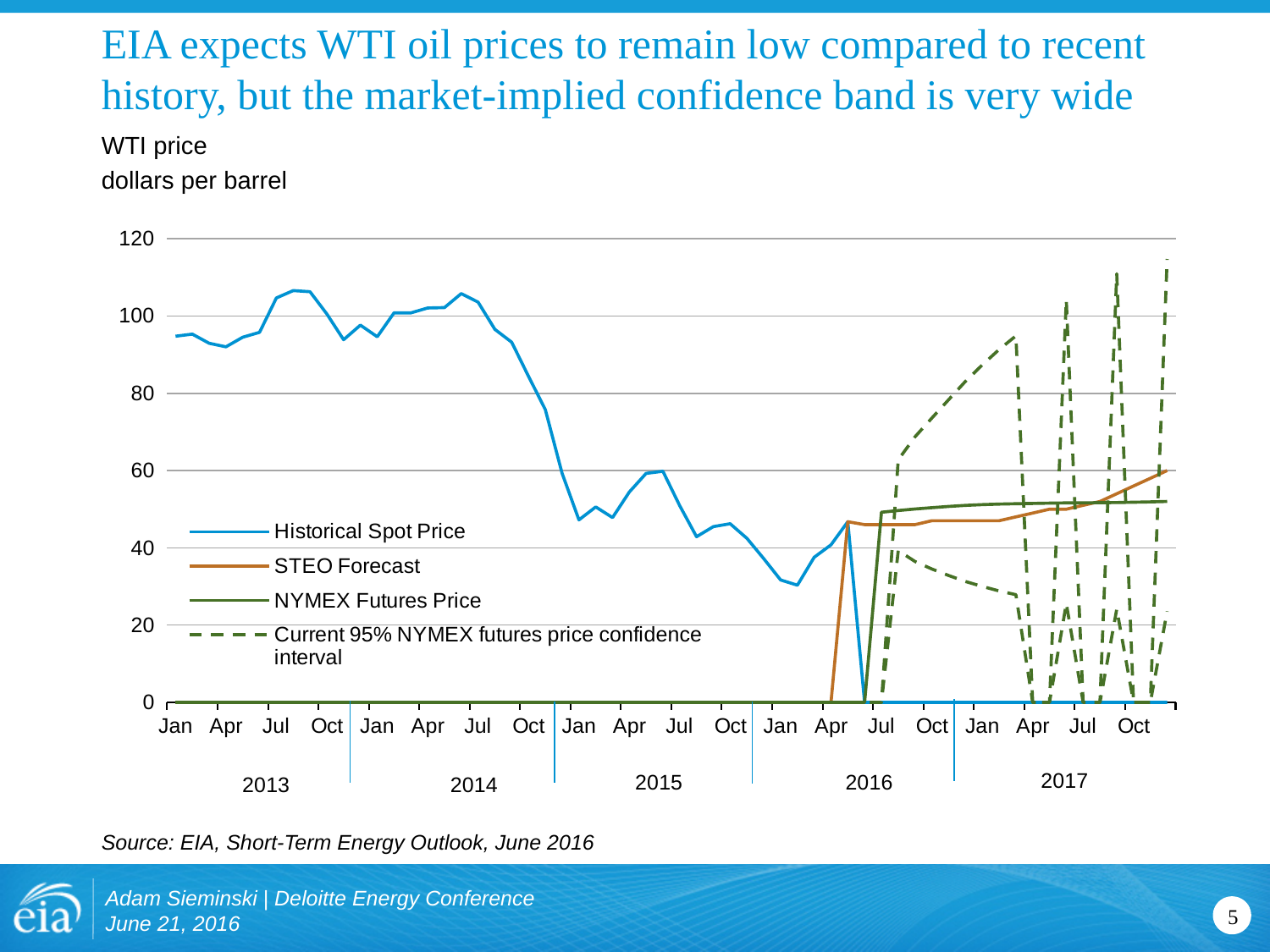
How many series does the chart legend list? 4 Is the STEO Forecast at the end of 2017 greater or less than 40 dollars per barrel? greater Does the Historical Spot Price rise or fall between mid-2014 and early 2016? fall What unit is the WTI price plotted in, according to the chart subtitle? dollars per barrel How many years are labeled along the x axis of the chart? 5 Which series is drawn with a dashed line in the chart? Current 95% NYMEX futures price confidence interval Is the Historical Spot Price in Jan 2013 greater or less than 80 dollars per barrel? greater Which is larger, the Historical Spot Price in Jan 2013 or in Jan 2016? Jan 2013 Is the NYMEX Futures Price at the end of 2017 greater or less than 60 dollars per barrel? less At the end of 2017, which is higher, the STEO Forecast or the NYMEX Futures Price? STEO Forecast What kind of chart is shown on the slide? line chart